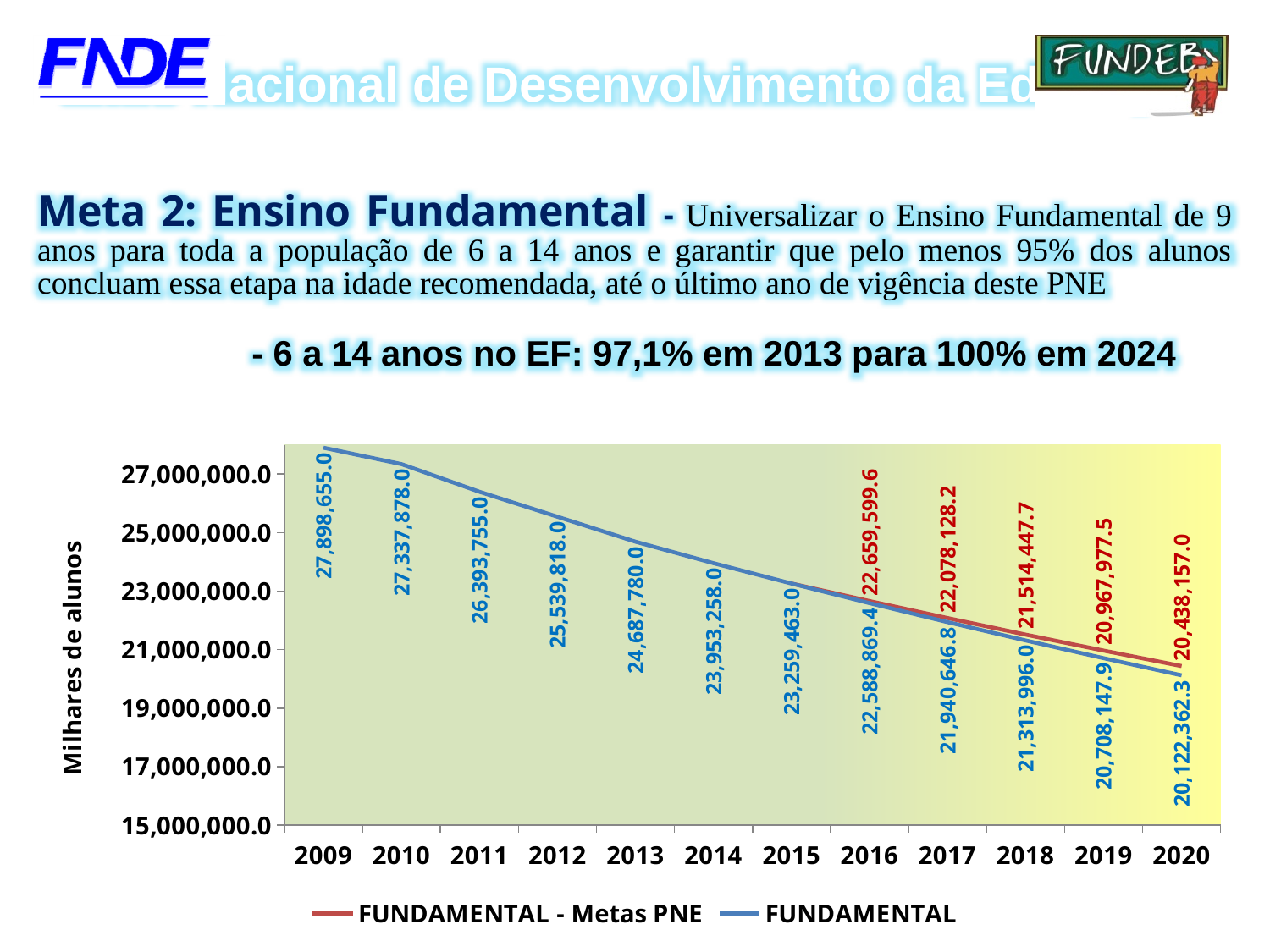
Does the FUNDAMENTAL series rise or fall from 2009 to 2020? Fall What is the difference between the FUNDAMENTAL - Metas PNE value and the FUNDAMENTAL value in 2020? 315,794.7 How many years are shown on the x axis of the chart? 12 What is the value of the FUNDAMENTAL - Metas PNE series in 2017? 22,078,128.2 In which year is the FUNDAMENTAL series at its lowest? 2020 What kind of chart is shown on the slide? Line chart Which series has the larger value in 2019, FUNDAMENTAL or FUNDAMENTAL - Metas PNE? FUNDAMENTAL - Metas PNE In which year is the FUNDAMENTAL series at its highest? 2009 What is the value of the FUNDAMENTAL series in 2009? 27,898,655.0 What is the value of the FUNDAMENTAL - Metas PNE series in 2020? 20,438,157.0 How many series does the chart legend list? 2 What is the value of the FUNDAMENTAL series in 2015? 23,259,463.0